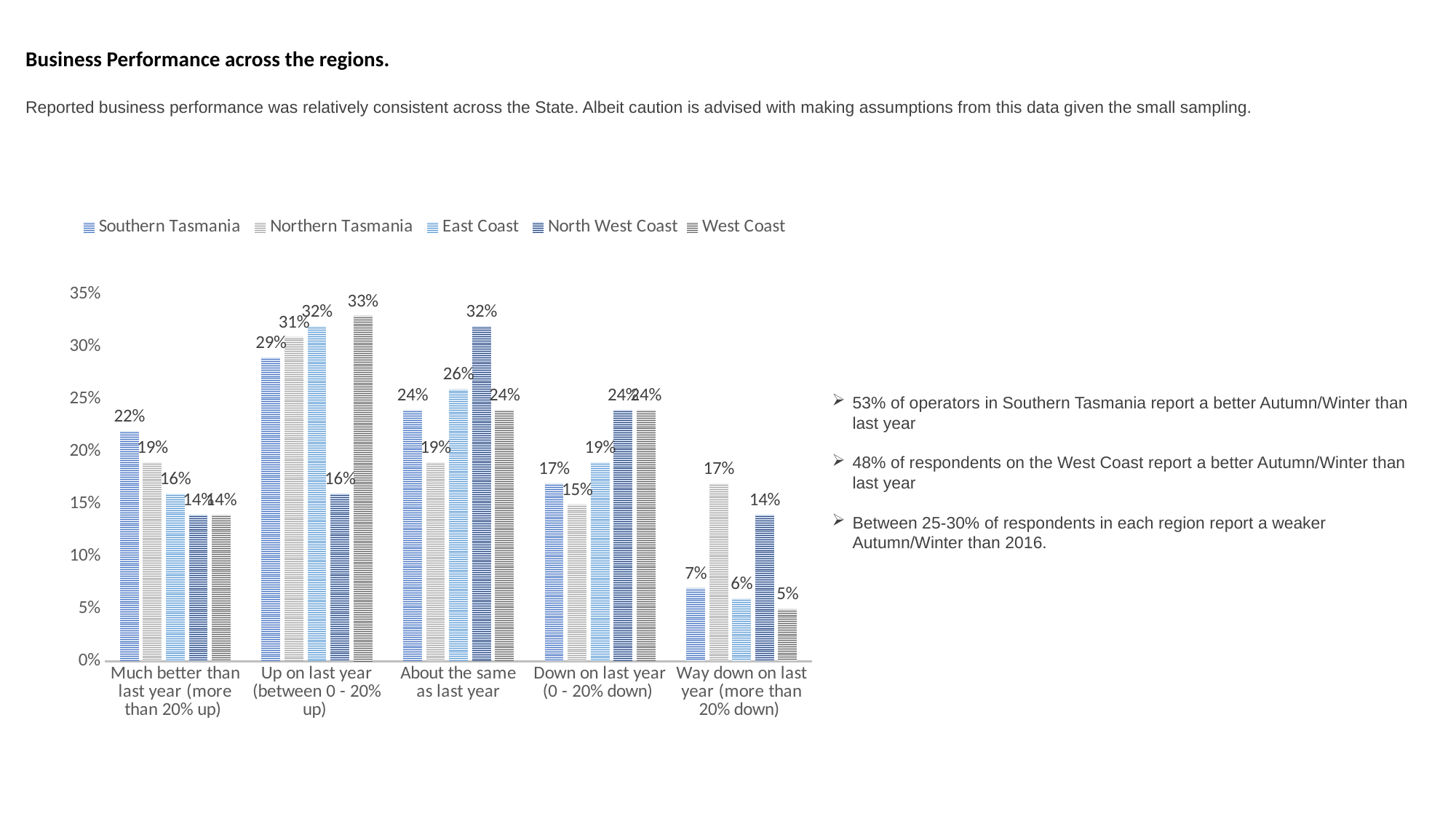
What is the value for West Coast in the 'Up on last year (between 0 - 20% up)' category? 33% Which region has the highest value in the 'Up on last year (between 0 - 20% up)' category? West Coast In the 'Down on last year (0 - 20% down)' category, which is larger: East Coast or Northern Tasmania? East Coast Which region has the lowest value in the 'Way down on last year (more than 20% down)' category? West Coast How many regions does the legend list? 5 How many performance categories are shown on the x axis? 5 What type of chart is shown on the slide? Bar chart In the 'Much better than last year (more than 20% up)' category, how many percentage points higher is Southern Tasmania than North West Coast? 8 percentage points What percentage of Northern Tasmania respondents reported 'Way down on last year (more than 20% down)'? 17% Which region is listed first in the chart legend? Southern Tasmania What is the value for North West Coast in the 'About the same as last year' category? 32% What percentage of Southern Tasmania respondents reported 'Much better than last year (more than 20% up)'? 22%